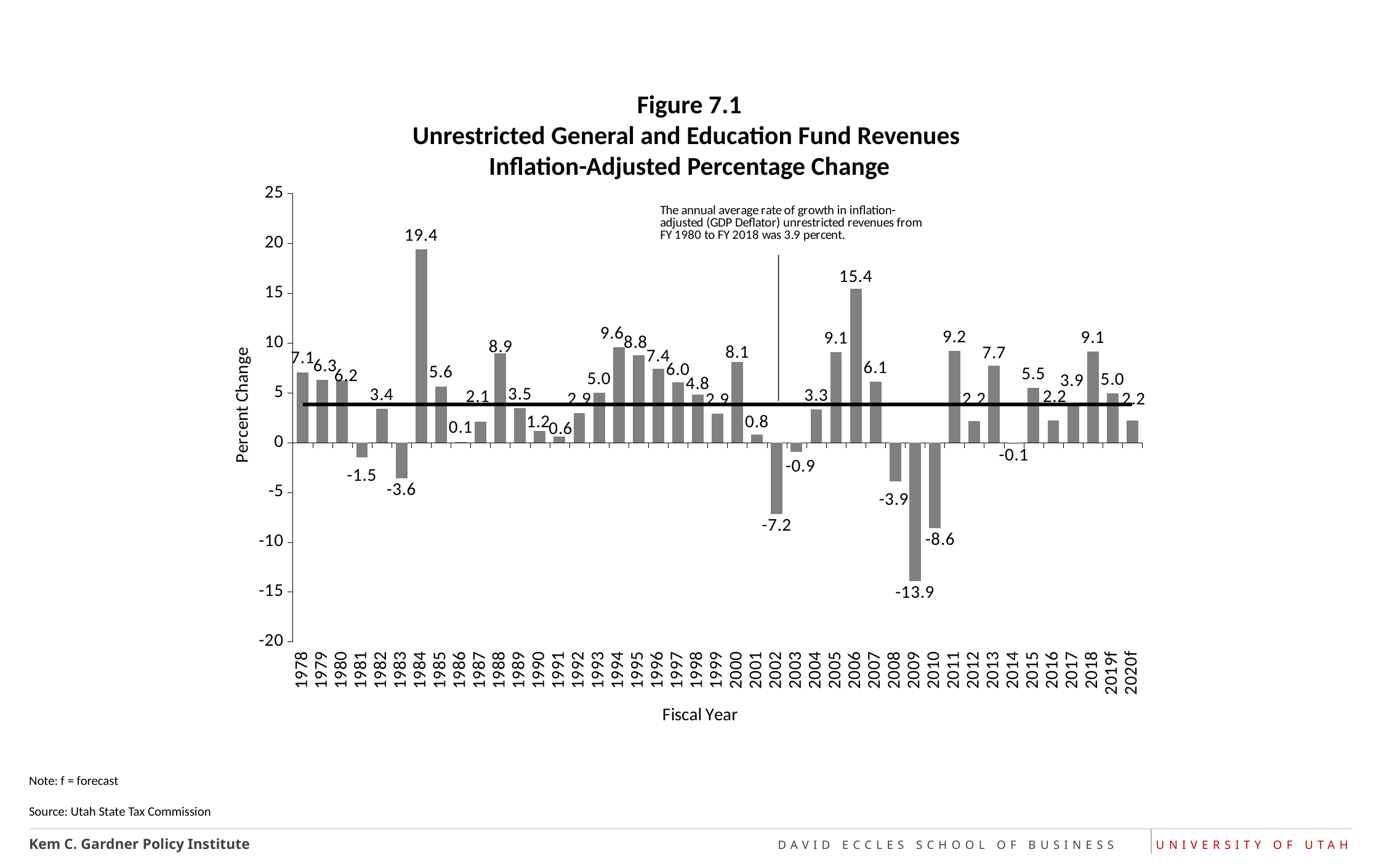
What is the inflation-adjusted percentage change for fiscal year 1984? 19.4 What is the inflation-adjusted percentage change for fiscal year 2009? -13.9 How many fiscal years are plotted on the chart? 43 Do the values rise or fall from fiscal year 1994 to fiscal year 1999? Fall Which fiscal year has the lower percentage change, 2002 or 2010? 2010 Which fiscal year has the lowest percentage change? 2009 What kind of chart is shown on the slide? Bar chart Which fiscal year has the larger percentage change, 1994 or 2000? 1994 What is the difference between the percentage change in 1984 and in 2006? 4.0 According to the annotation, what was the annual average rate of growth from FY 1980 to FY 2018? 3.9 percent What is the value shown for fiscal year 2020f? 2.2 Which fiscal year has the highest percentage change? 1984